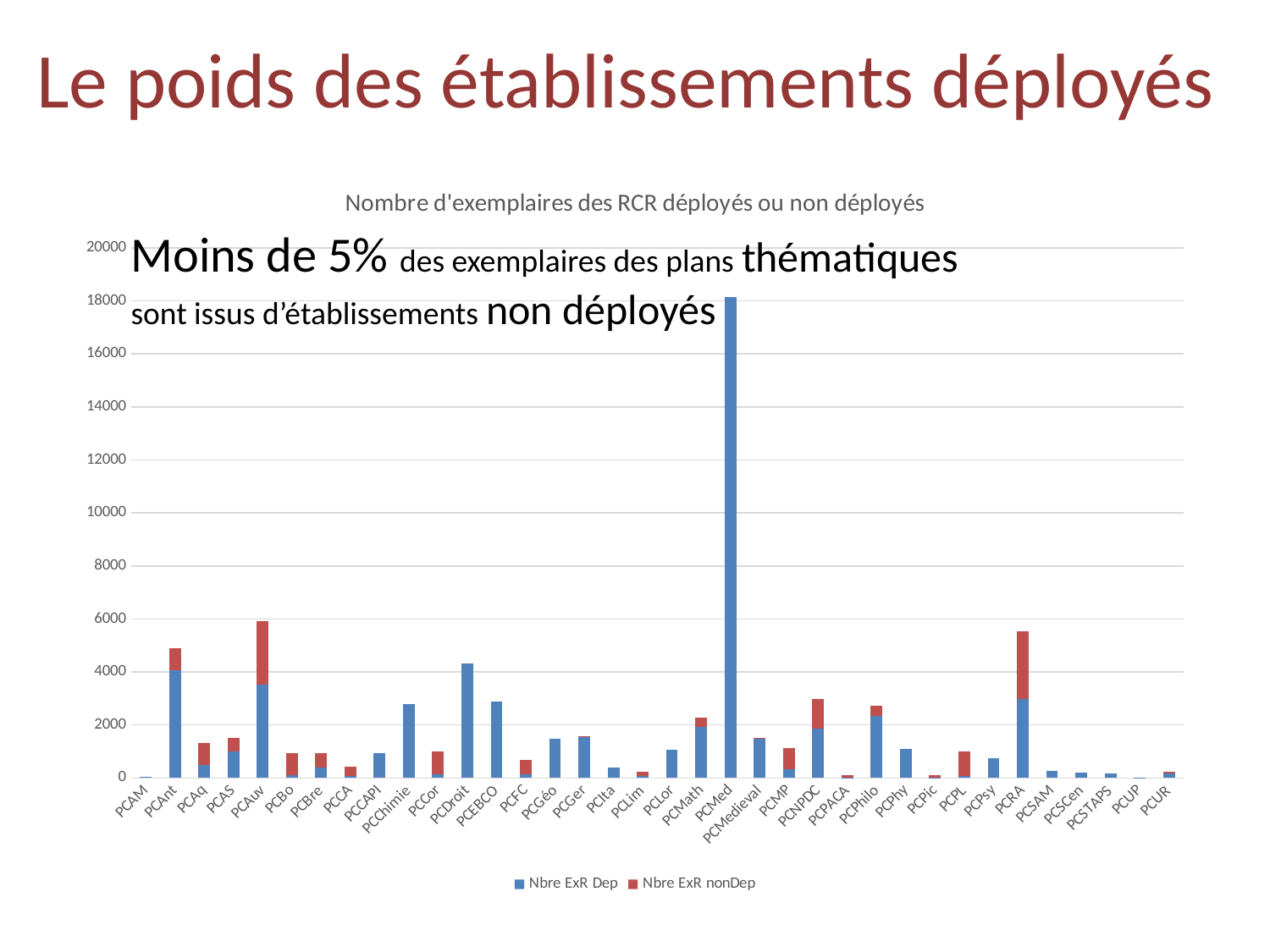
Is the total value for PCAnt greater or less than 4000? greater Which category has the highest total bar in the chart? PCMed Which has the larger total bar, PCMed or PCAnt? PCMed Which series is shown in red in the chart? Nbre ExR nonDep What kind of chart is shown on the slide? Stacked bar chart How many categories are shown along the x axis of the chart? 36 What is the title of the chart? Nombre d'exemplaires des RCR déployés ou non déployés Is the total value for PCChimie greater or less than 4000? less How many series does the chart legend list? 2 Is the total value for PCRA greater or less than 4000? greater Which has the larger total bar, PCDroit or PCChimie? PCDroit